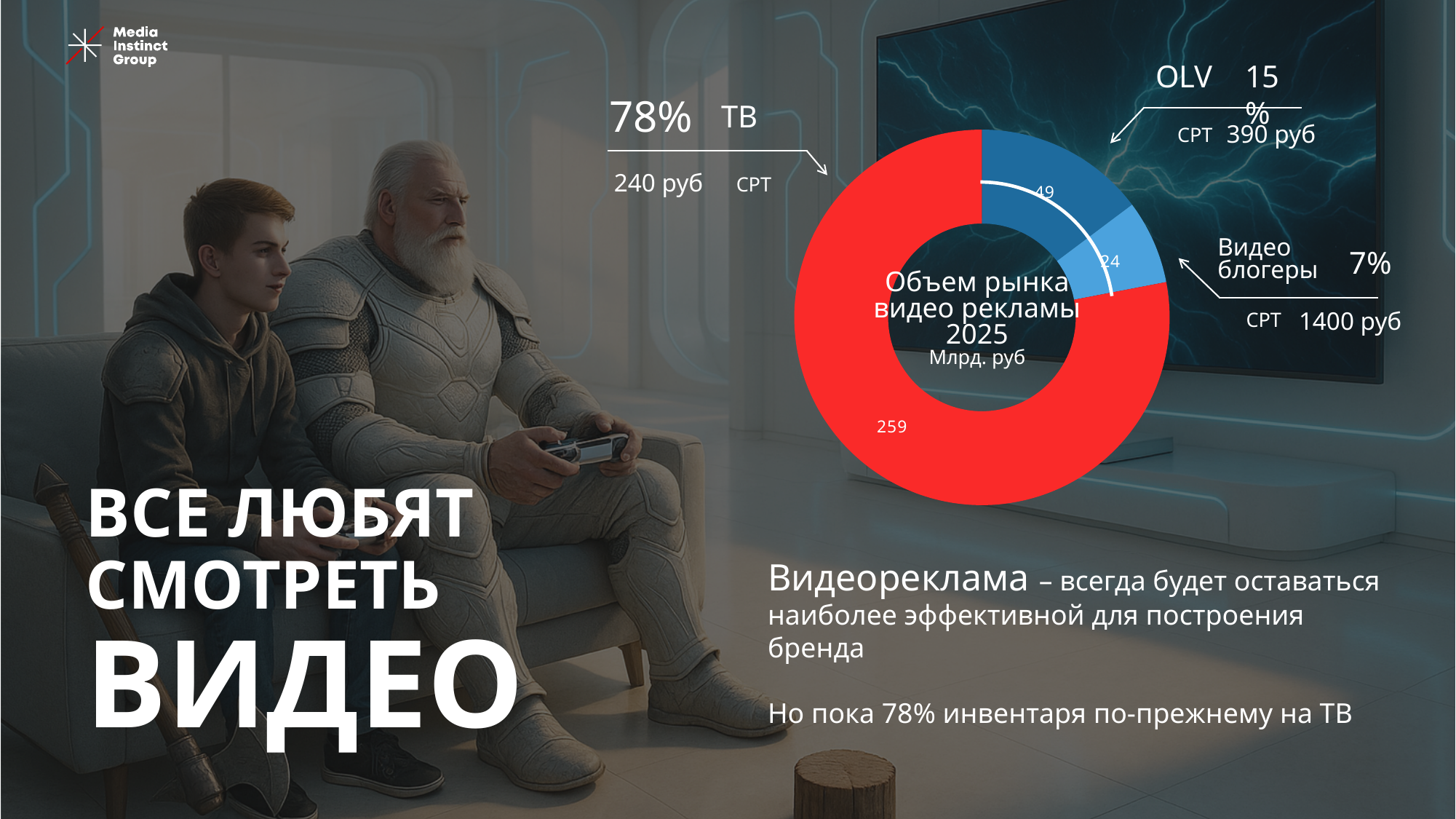
Which segment of the donut chart is the largest? ТВ What is the value for OLV in the donut chart? 49 Which is larger in the donut chart, OLV or Видео блогеры? OLV What share of the video advertising market does OLV hold according to the slide? 15% What is the difference between the ТВ value and the OLV value in the donut chart? 210 What share of the video advertising market does ТВ hold according to the slide? 78% Which segment of the donut chart is the smallest? Видео блогеры What is the value for Видео блогеры in the donut chart? 24 How many segments does the donut chart have? 3 What is the value for ТВ in the donut chart? 259 What kind of chart is shown on the slide? Donut (pie) chart What is the title shown in the centre of the donut chart? Объем рынка видео рекламы 2025 Млрд. руб